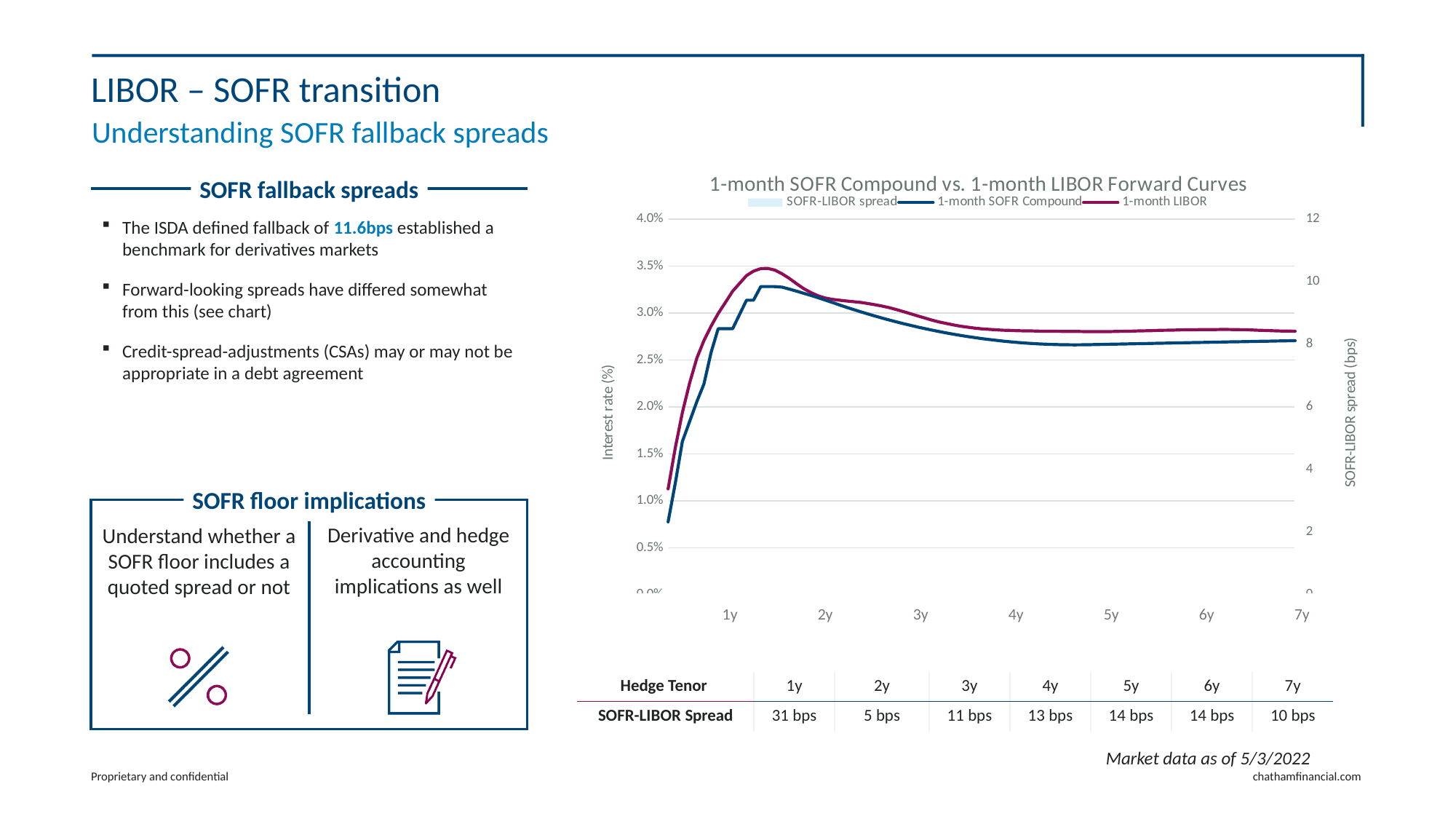
Is the 1-month LIBOR value at the 1y tenor greater or less than 3.0%? greater What kind of chart is shown on the slide? line chart What is the title of the chart? 1-month SOFR Compound vs. 1-month LIBOR Forward Curves In the table below the chart, what is the SOFR-LIBOR Spread for the 1y hedge tenor? 31 bps At the 1y tenor, which line is higher: 1-month LIBOR or 1-month SOFR Compound? 1-month LIBOR In the table below the chart, which hedge tenor has the lowest SOFR-LIBOR Spread? 2y At the 4y tenor, which line is higher: 1-month LIBOR or 1-month SOFR Compound? 1-month LIBOR How many series does the chart legend list? 3 How many tenor labels are shown on the x axis of the chart? 7 Between the 2y and 4y tenors, does the 1-month LIBOR line rise or fall? fall What is the label of the left vertical axis of the chart? Interest rate (%) Is the 1-month SOFR Compound value at the 4y tenor greater or less than 3.0%? less